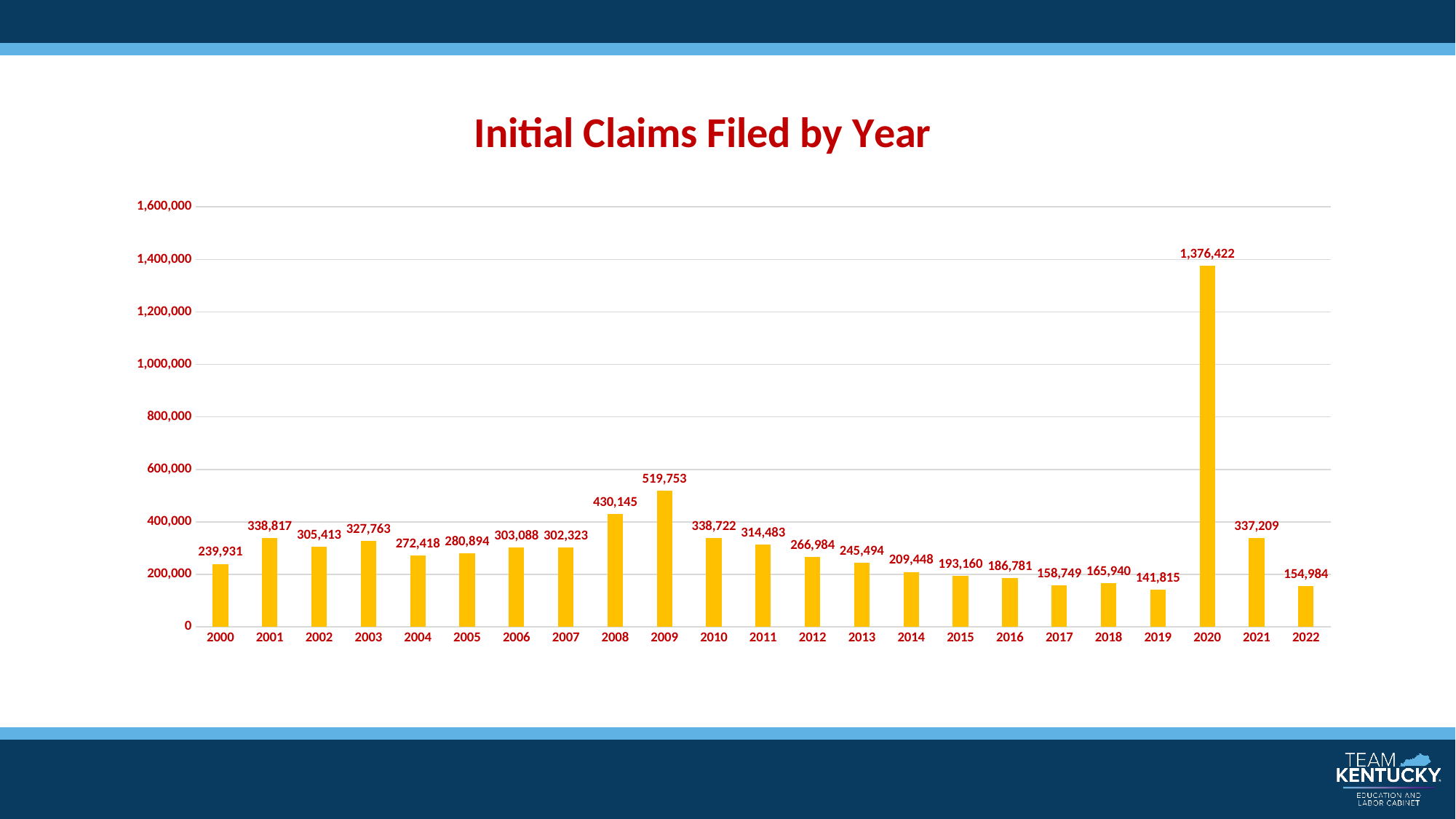
What is the difference between the initial claims filed in 2009 and in 2008? 89,608 Do the values rise or fall from 2014 to 2017? Fall Which year has the lowest number of initial claims filed? 2019 Which year has the highest number of initial claims filed? 2020 What is the title of the chart? Initial Claims Filed by Year What type of chart is shown on the slide? Bar chart Which year had more initial claims filed, 2002 or 2003? 2003 How many initial claims were filed in 2009? 519,753 What is the value shown for 2020? 1,376,422 How many years are shown on the x axis of the chart? 23 How many initial claims were filed in 2022? 154,984 What is the difference between the initial claims filed in 2020 and in 2019? 1,234,607